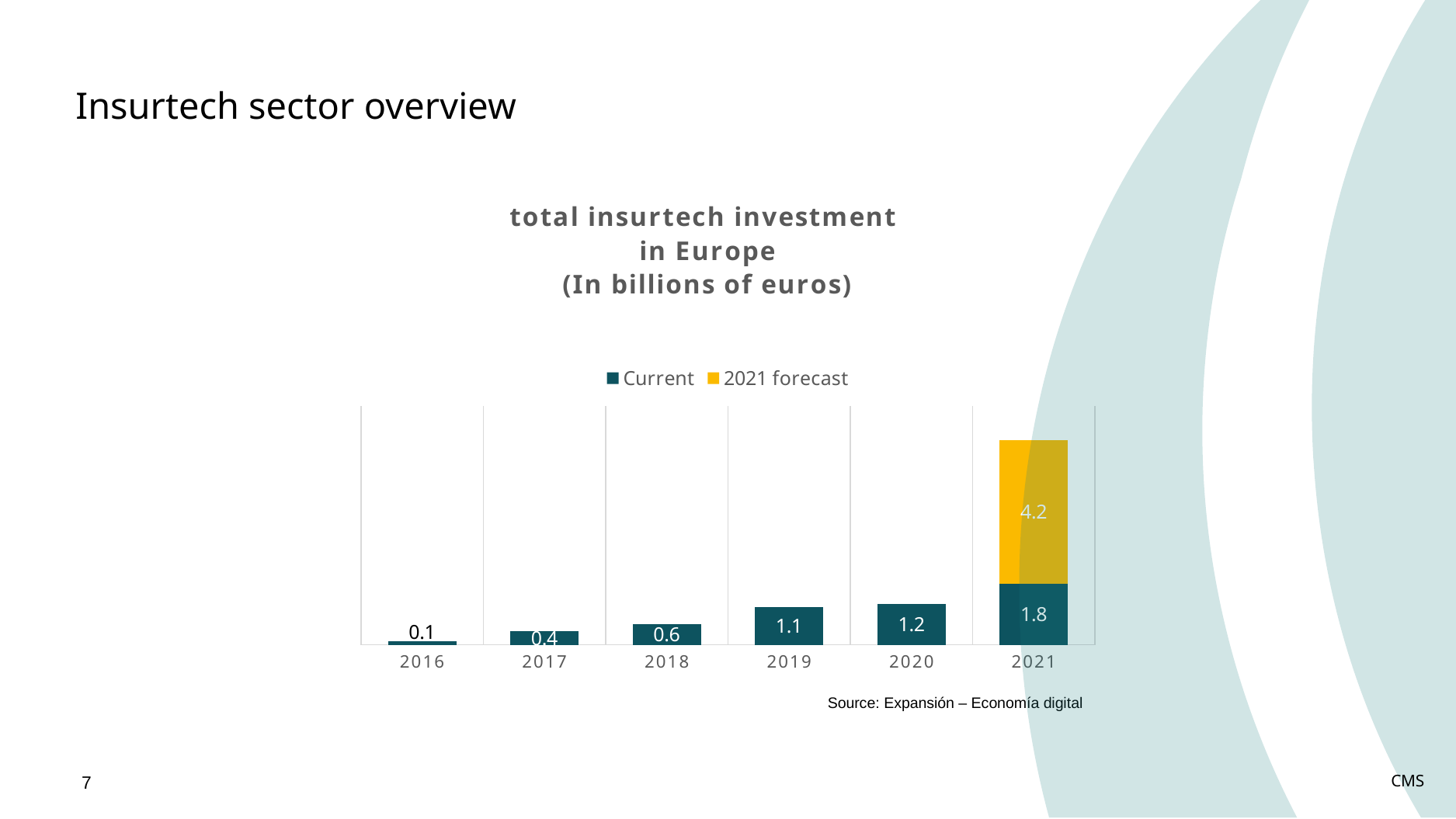
Which year has the lowest Current value? 2016 What is the Current value for 2021? 1.8 What is the Current value for 2020? 1.2 How many series does the legend list? 2 Which is larger, the Current value for 2018 or for 2020? 2020 What is the 2021 forecast value shown for 2021? 4.2 What is the difference between the Current values for 2019 and 2017? 0.7 Do the Current values rise or fall from 2016 to 2021? Rise What kind of chart is shown on the slide? Bar chart What is the Current value for 2018? 0.6 How many years are shown on the x axis? 6 Which year has the highest Current value? 2021